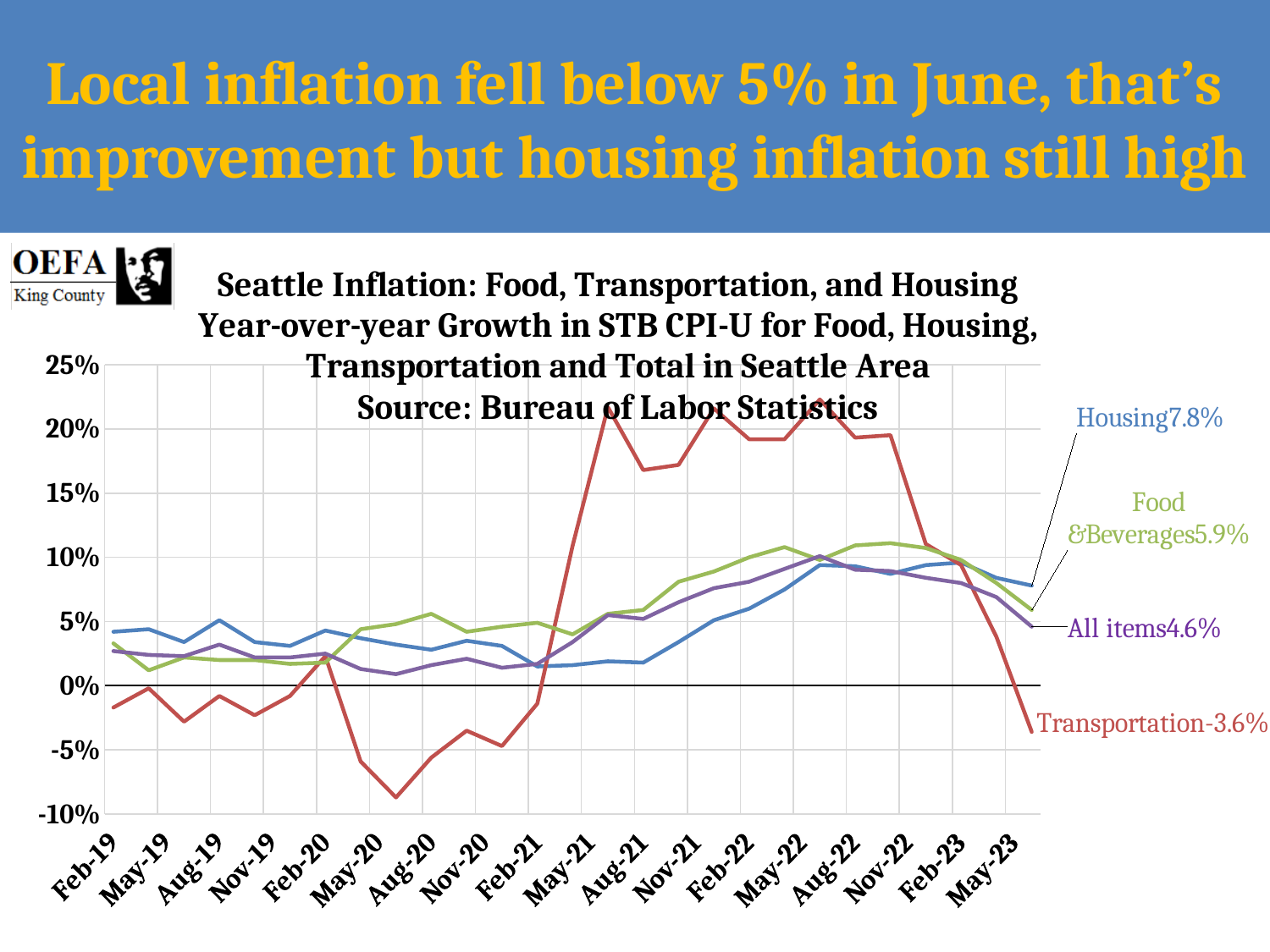
What is the difference between the latest labelled values for Housing and All items? 3.2 percentage points Which has the larger latest labelled value, Food & Beverages or All items? Food & Beverages Which series has the lowest latest labelled value? Transportation What source is cited in the chart title? Bureau of Labor Statistics Is the peak value of the Transportation line greater or less than 20%? greater Which series has the highest latest labelled value? Housing What is the latest labelled value for Food & Beverages? 5.9% What is the latest labelled value for Transportation? -3.6% What kind of chart is shown on the slide? Line chart What is the latest labelled value for Housing? 7.8% How many data series are plotted on the chart? 4 What is the latest labelled value for All items? 4.6%